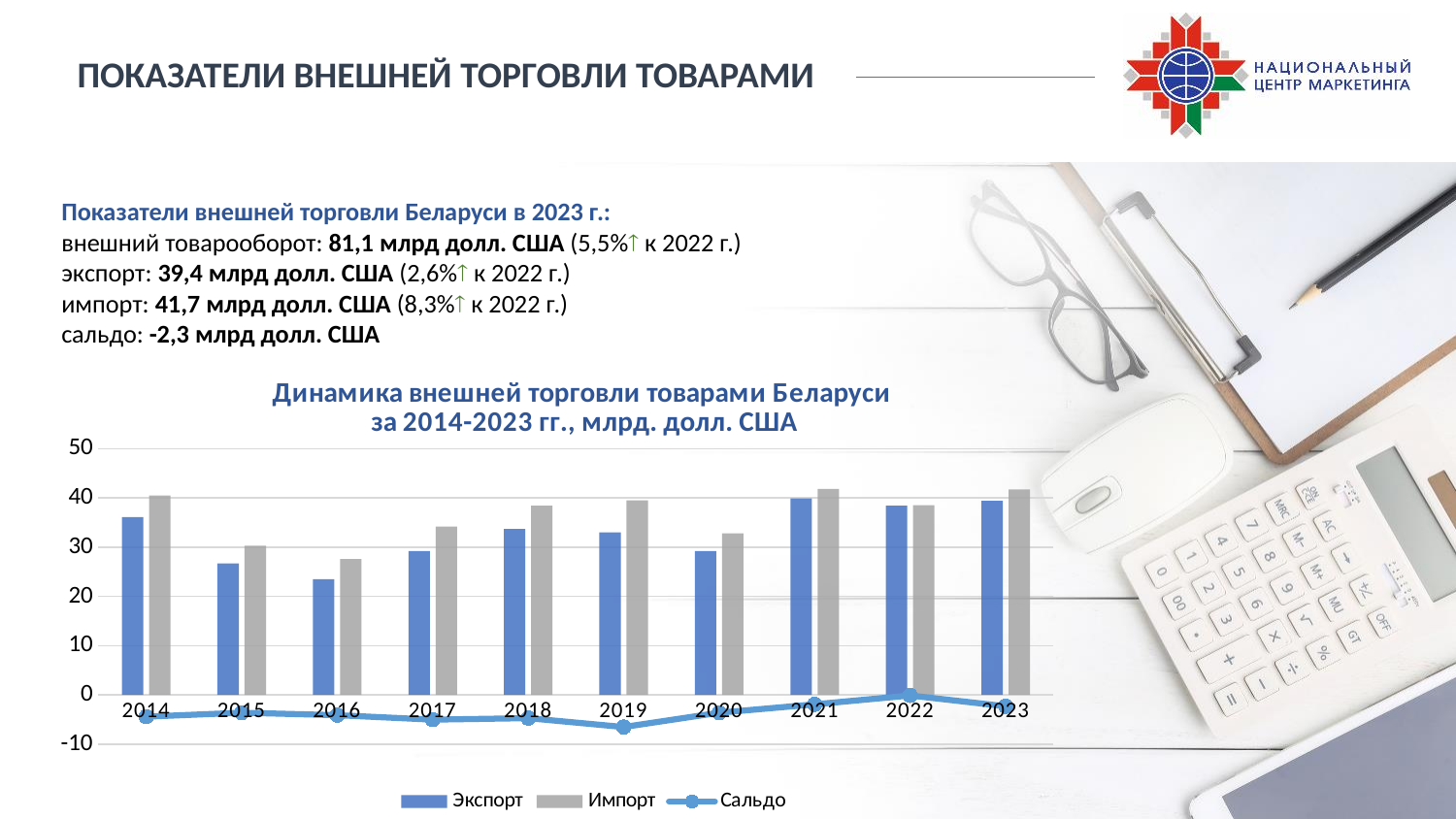
How many series does the chart legend list? 3 How many years are shown on the x axis of the chart? 10 In which year is the Экспорт bar the lowest? 2016 In which year does the Сальдо line reach its lowest point? 2019 What are the three series named in the chart legend? Экспорт, Импорт, Сальдо Is the Импорт value for 2021 greater or less than 40? greater In 2017, which is larger: Экспорт or Импорт? Импорт Is the Экспорт value for 2016 greater or less than 30? less In which year is the Импорт bar the lowest? 2016 Is the Экспорт value for 2014 greater or less than 30? greater What kind of chart is shown on the slide? A bar chart combined with a line Do the Экспорт bars rise or fall from 2014 to 2016? fall